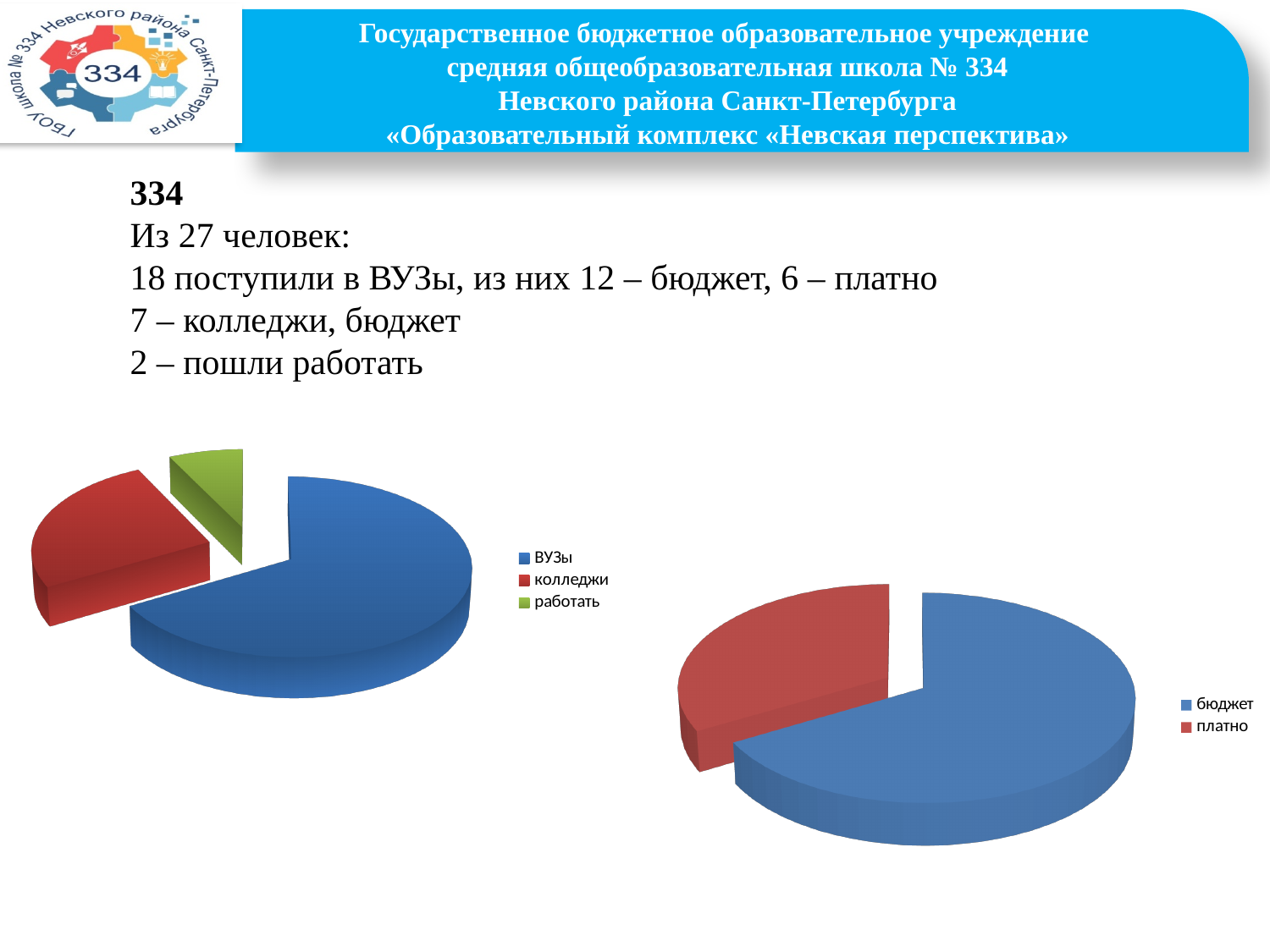
In the right pie chart, which category has the larger slice? бюджет What kind of chart is the chart on the left of the slide? pie chart In the left pie chart, what colour is the slice for работать? green In the right pie chart, what colour is the slice for платно? red How many slices does the right pie chart have? 2 How many entries does the legend of the left pie chart list? 3 In the left pie chart, which category has the largest slice? ВУЗы How many slices does the left pie chart have? 3 In the left pie chart, which category has the smallest slice? работать What kind of chart is the chart on the right of the slide? pie chart In the left pie chart, which slice is larger: колледжи or работать? колледжи How many entries does the legend of the right pie chart list? 2